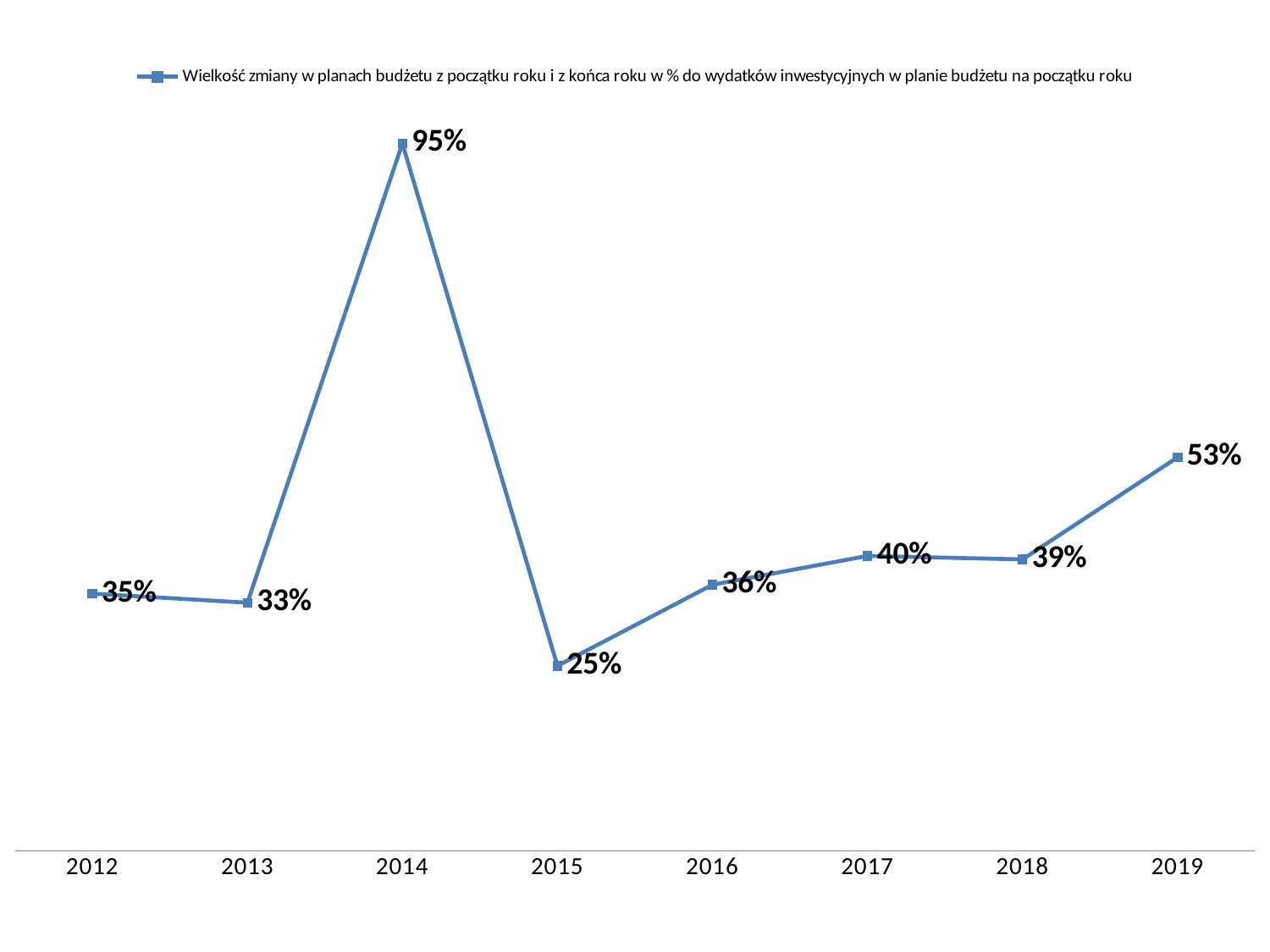
Do the values rise or fall from 2015 to 2017? rise How many years are shown on the x axis? 8 What is the value for 2015? 25% Which is larger, the value for 2012 or the value for 2013? 2012 What is the value for 2019? 53% What is the difference between the values for 2014 and 2015? 70% What kind of chart is this? line chart Which year has the highest value? 2014 What is the value for 2017? 40% What is the difference between the values for 2019 and 2018? 14% Which year has the lowest value? 2015 What is the value for 2014? 95%